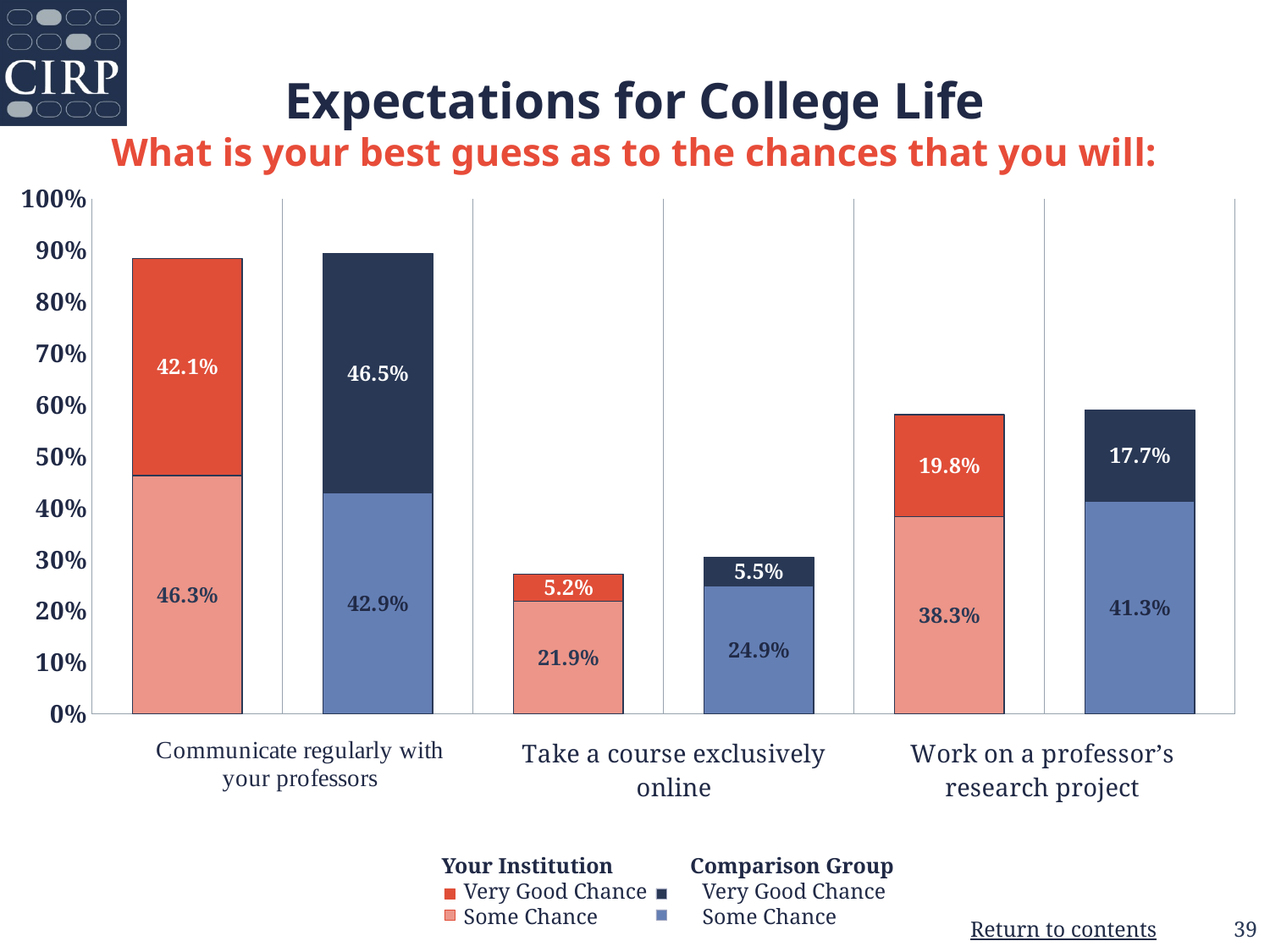
What is the 'Some Chance' value for the Comparison Group for 'Work on a professor's research project'? 41.3% What is the difference between the 'Very Good Chance' values for Your Institution and the Comparison Group for 'Communicate regularly with your professors'? 4.4% Which category has the highest 'Some Chance' value for the Comparison Group? Communicate regularly with your professors How many categories are shown on the x axis? 3 What is the 'Very Good Chance' value for the Comparison Group for 'Take a course exclusively online'? 5.5% Which is larger for 'Work on a professor's research project': the 'Very Good Chance' value for Your Institution or for the Comparison Group? Your Institution What is the 'Some Chance' value for Your Institution for 'Take a course exclusively online'? 21.9% What is the total of the stacked bar for the Comparison Group for 'Work on a professor's research project'? 59.0% What is the total of the stacked bar for Your Institution for 'Take a course exclusively online'? 27.1% What kind of chart is shown on the slide? Stacked bar chart Which category has the lowest 'Very Good Chance' value for Your Institution? Take a course exclusively online What is the 'Very Good Chance' value for Your Institution for 'Communicate regularly with your professors'? 42.1%